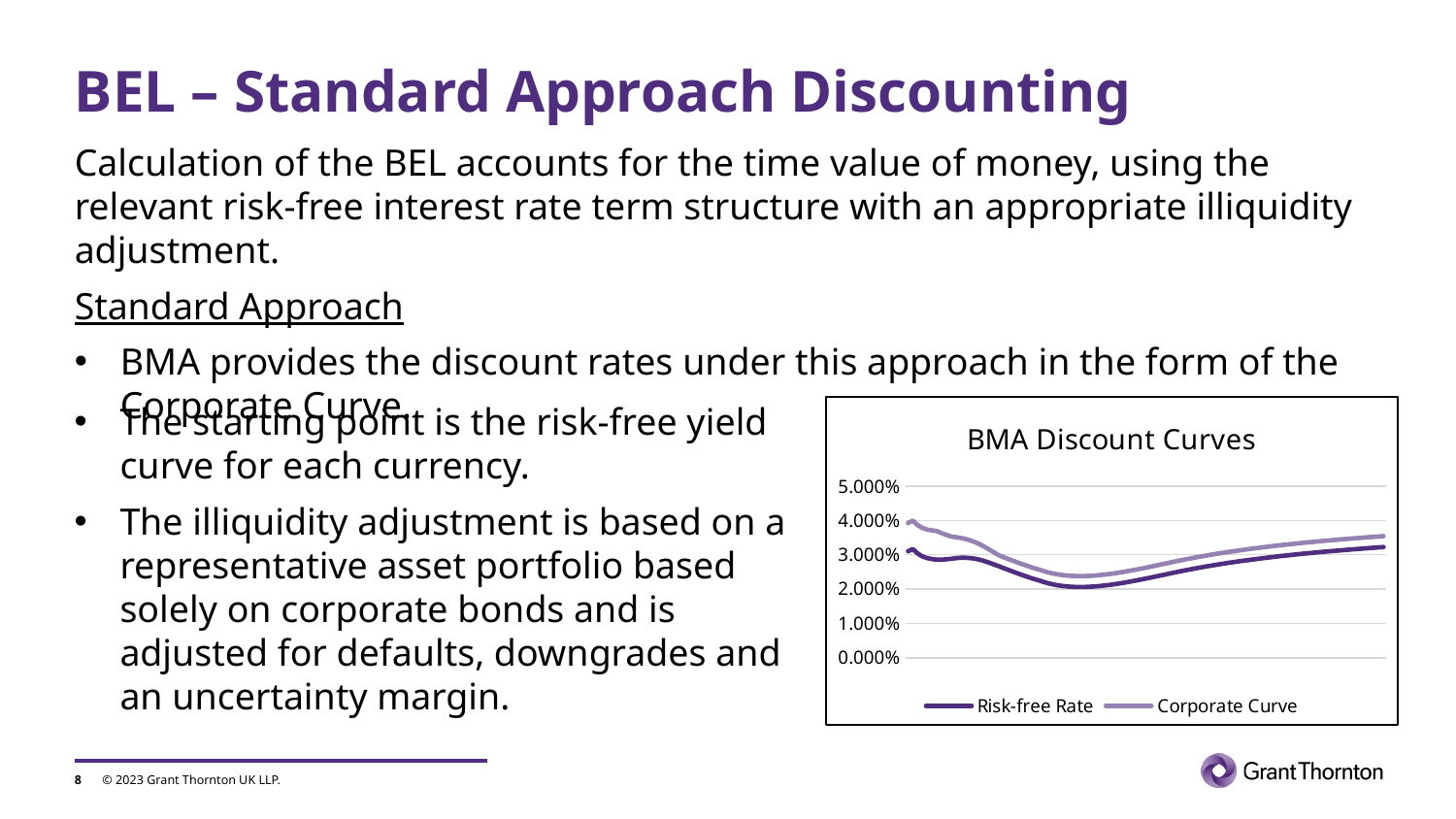
Which series lies higher on the chart, Risk-free Rate or Corporate Curve? Corporate Curve What is the title of the chart? BMA Discount Curves What type of chart is shown on the slide? line chart Is the lowest point of the Corporate Curve greater or less than 3.000%? less Is the starting value of the Corporate Curve greater or less than 3.000%? greater Is the highest point of the Corporate Curve greater or less than 5.000%? less What are the two series named in the chart's legend? Risk-free Rate and Corporate Curve Do the curves initially rise or fall moving from left to right along the x axis? fall How many series does the chart's legend list? 2